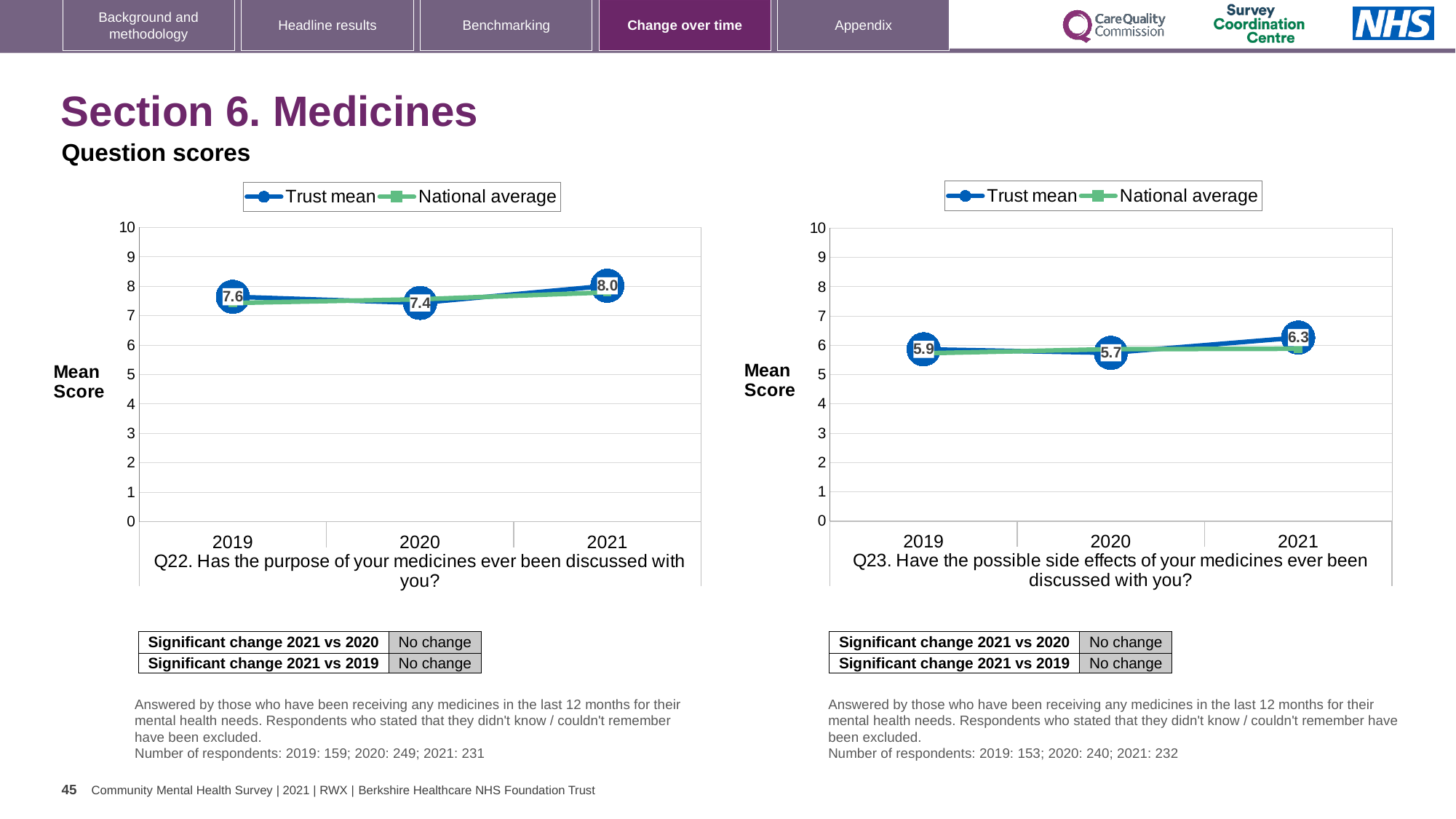
What kind of chart is the Q22 chart (left)? Line chart In the Q22 chart (left), what is the Trust mean for 2019? 7.6 How many series does the legend of the Q22 chart (left) list? 2 In the Q23 chart (right), which year has the lowest Trust mean? 2020 In the Q22 chart (left), what is the difference between the Trust mean for 2021 and the Trust mean for 2020? 0.6 How many years are plotted on the x axis of the Q23 chart (right)? 3 In the Q22 chart (left), which year has the highest Trust mean? 2021 In the Q23 chart (right), is the Trust mean for 2019 larger or smaller than the Trust mean for 2021? smaller In the Q23 chart (right), what is the Trust mean for 2020? 5.7 In the Q23 chart (right), what is the difference between the Trust mean for 2021 and the Trust mean for 2019? 0.4 In the Q23 chart (right), what is the Trust mean for 2021? 6.3 In the Q22 chart (left), what is the Trust mean for 2021? 8.0